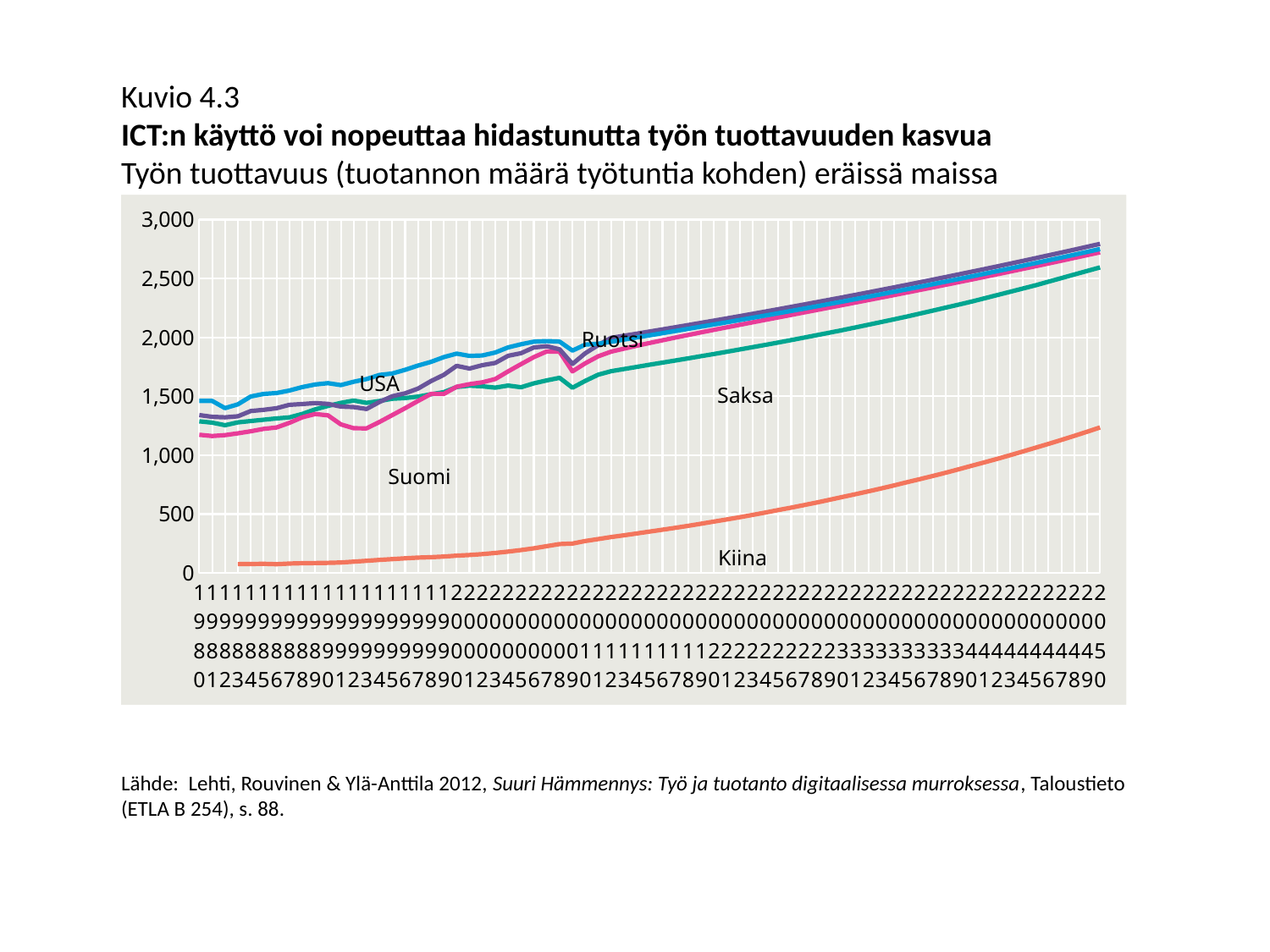
How many countries are plotted as lines on the chart? 5 Is the value for Kiina in 2050 greater or less than 1,000? greater Is the value for Suomi in 1980 greater or less than 1,500? less Is the value for Kiina in 2040 greater or less than 500? greater In 2000, which is larger, the value for Suomi or the value for Kiina? Suomi What is the highest value shown on the vertical axis? 3,000 Do the lines generally rise or fall from 1980 to 2050? rise Which country's line is the lowest across the whole chart? Kiina What kind of chart is shown on the slide? line chart In 2050, which is larger, the value for Saksa or the value for Kiina? Saksa